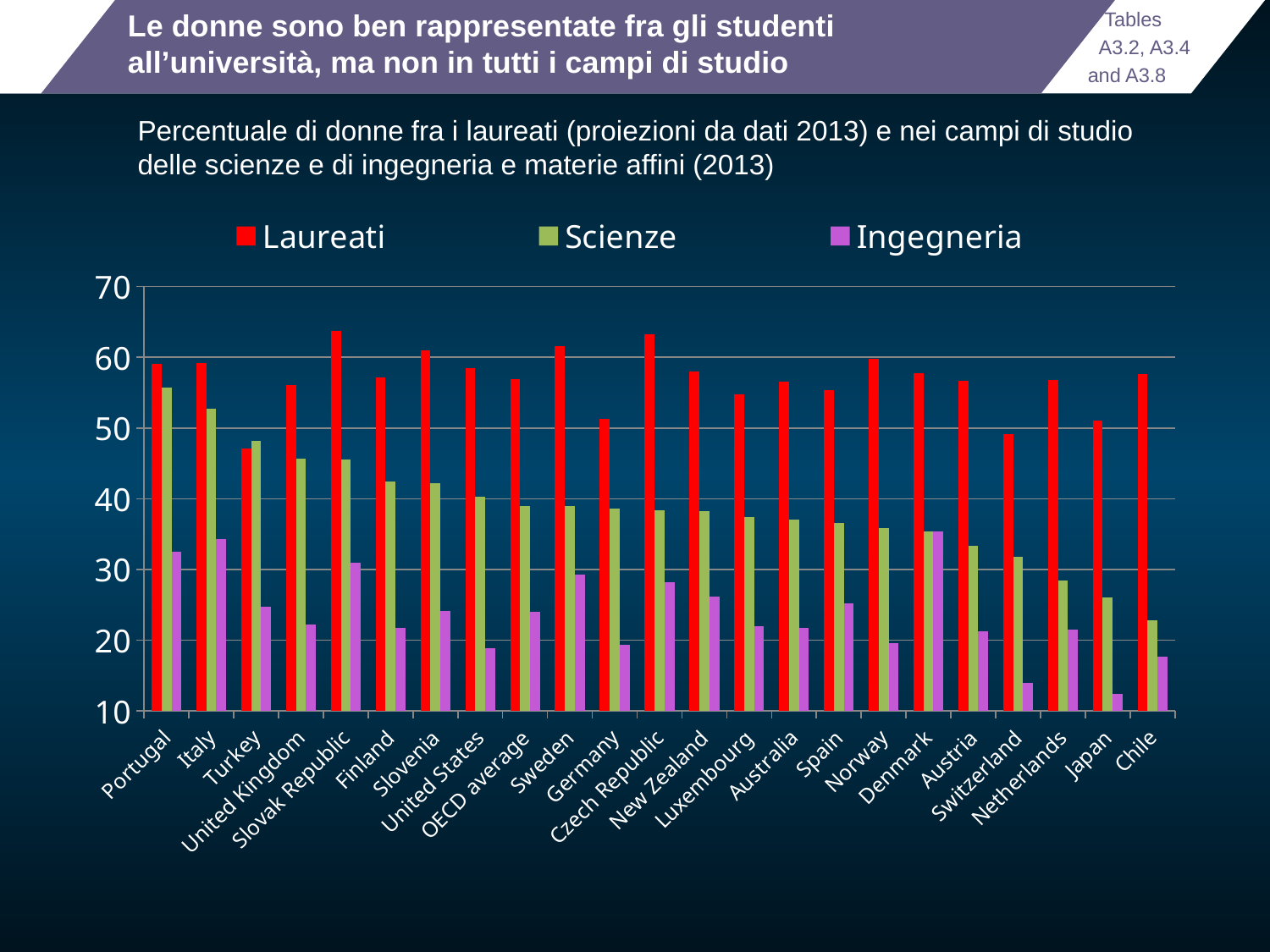
What colour represents the Ingegneria series in the legend? purple Is the Scienze value for Turkey greater or less than 50? less Is the Ingegneria value for Denmark greater or less than 30? greater How many countries/categories are shown on the x axis? 23 Which is larger, the Scienze value for Portugal or the Scienze value for Chile? Portugal How many series does the legend list? 3 Do the Scienze values generally rise or fall from left to right along the x axis? fall Is the Ingegneria value for Japan greater or less than 20? less What kind of chart is shown on the slide? bar chart Which category has the highest Scienze value? Portugal Which category has the lowest Scienze value? Chile